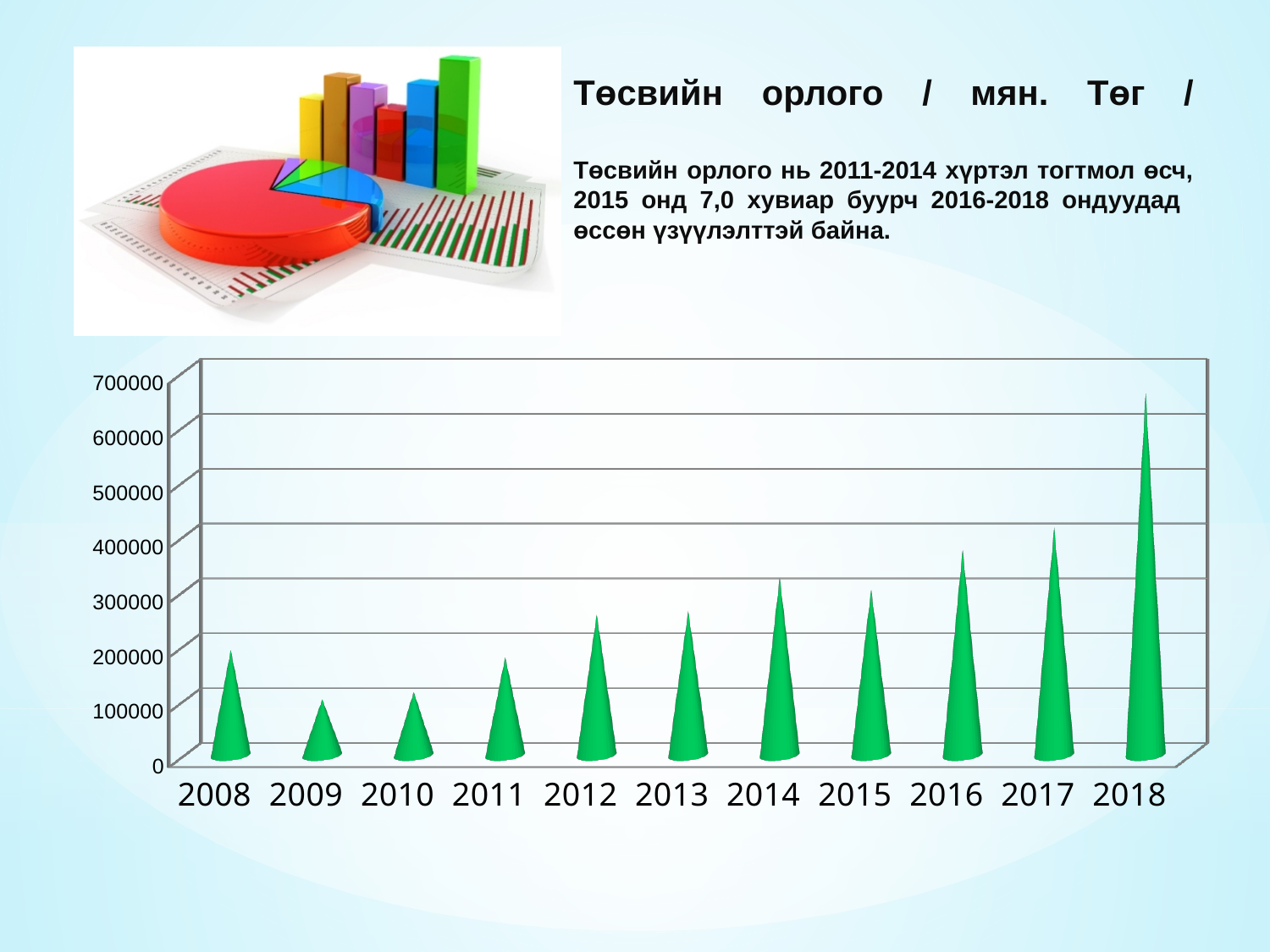
How many years are shown on the x axis of the chart? 11 Is the value for 2016 greater or less than 300000? greater What kind of chart is shown on the slide? bar chart Do the values rise or fall from 2011 to 2014? rise Is the value for 2008 greater or less than 100000? greater Is the value for 2018 greater or less than 600000? greater What is the title given above the chart on the slide? Төсвийн орлого / мян. Төг / Which is larger, the value for 2014 or the value for 2015? 2014 Which year has the highest value in the chart? 2018